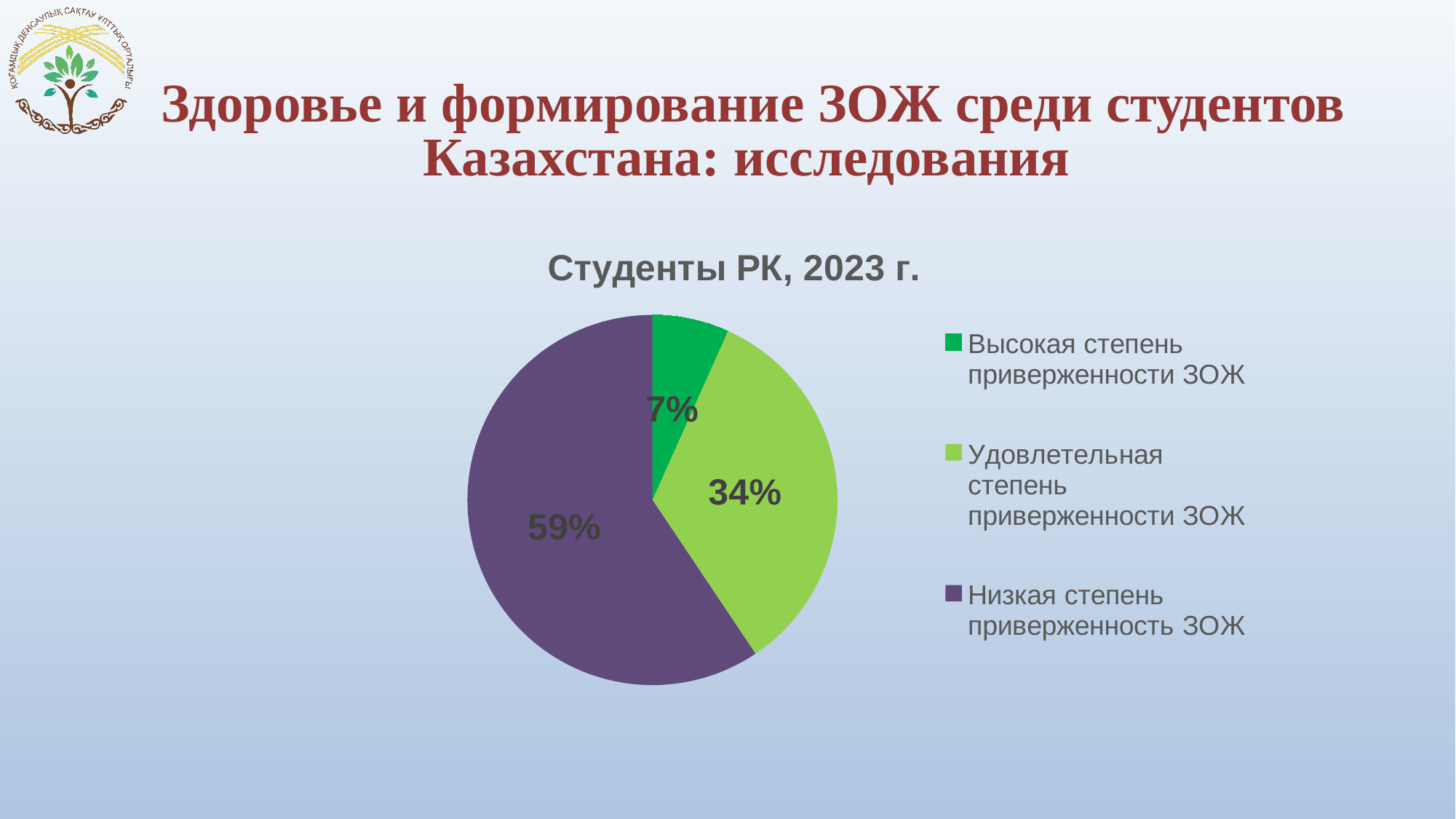
Which category has the largest slice of the pie? Низкая степень приверженность ЗОЖ How many categories does the pie chart show? 3 What share of students has a satisfactory degree of adherence to a healthy lifestyle (Удовлетельная степень приверженности ЗОЖ)? 34% What colour is the slice for low adherence to a healthy lifestyle (Низкая степень приверженность ЗОЖ)? purple What type of chart is shown on the slide? pie chart What share of students has a high degree of adherence to a healthy lifestyle (Высокая степень приверженности ЗОЖ)? 7% Which category has the smallest slice of the pie? Высокая степень приверженности ЗОЖ What share of students has a low degree of adherence to a healthy lifestyle (Низкая степень приверженность ЗОЖ)? 59% What is the difference in percentage points between the low-adherence slice and the satisfactory-adherence slice? 25 Which is larger: the share with satisfactory adherence or the share with high adherence? Удовлетельная степень приверженности ЗОЖ What is the title of the chart? Студенты РК, 2023 г. What is the difference in percentage points between the satisfactory-adherence slice and the high-adherence slice? 27